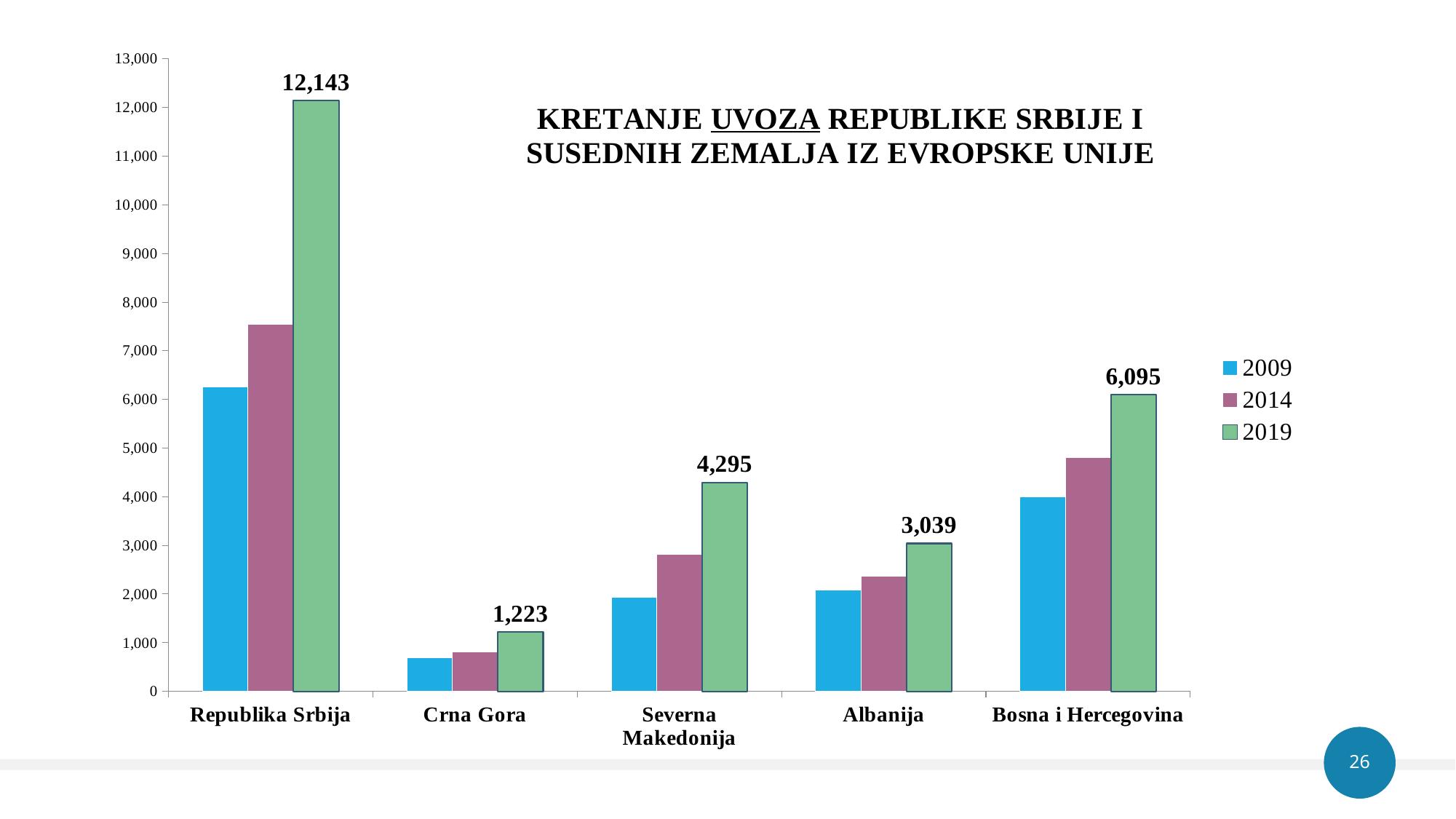
Which is larger: the 2019 value for Albanija or the 2019 value for Severna Makedonija? Severna Makedonija Which country has the highest 2019 value? Republika Srbija How many series does the legend list? 3 What is the 2019 value for Bosna i Hercegovina? 6,095 How many countries are shown on the x axis? 5 What kind of chart is shown on the slide? Bar chart Which country has the lowest 2019 value? Crna Gora What is the 2019 value for Republika Srbija? 12,143 Is the 2014 value for Republika Srbija greater or less than 7,000? greater What is the 2019 value for Crna Gora? 1,223 What is the 2019 value for Severna Makedonija? 4,295 What is the difference between the 2019 values for Republika Srbija and Bosna i Hercegovina? 6,048